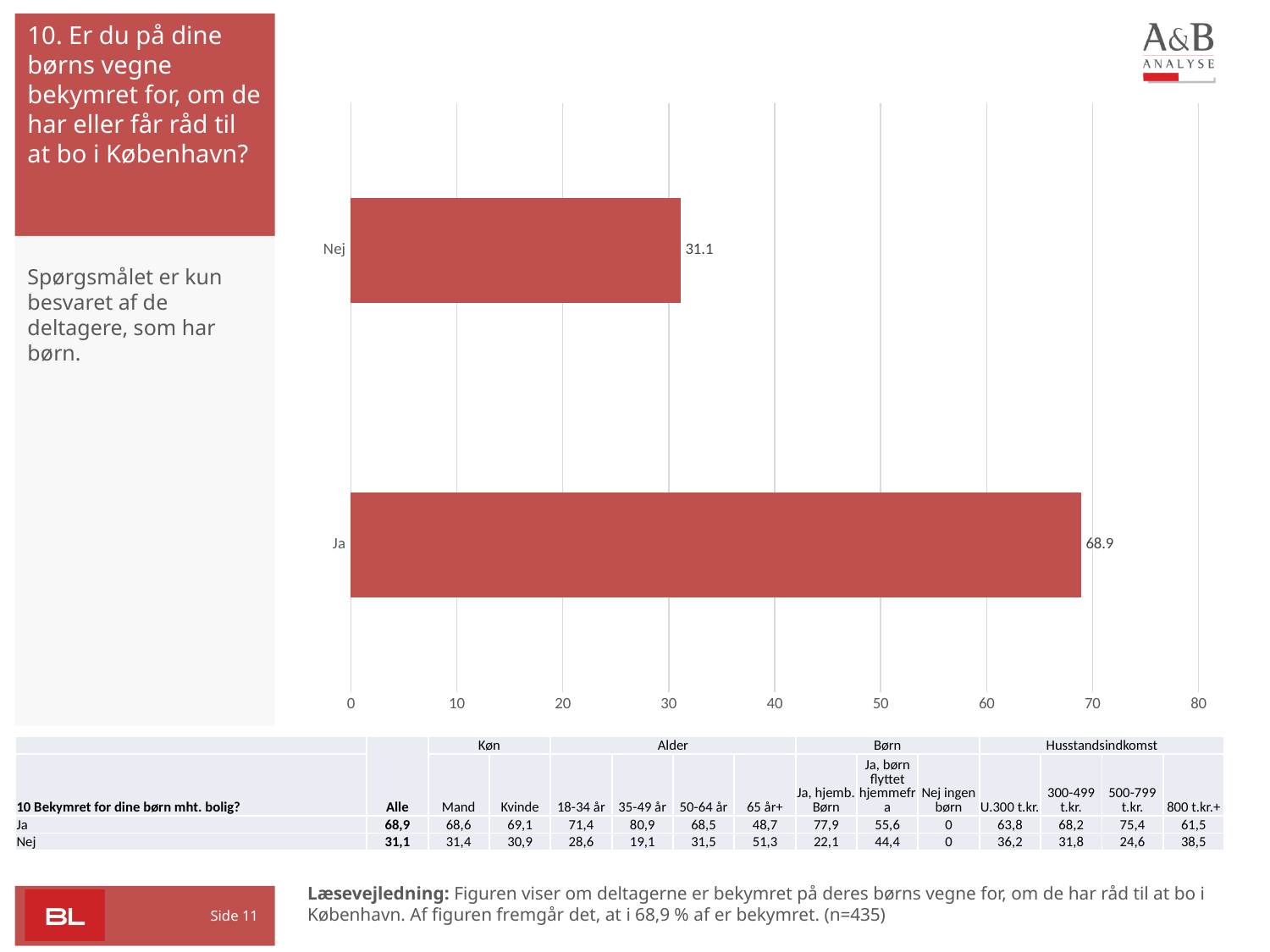
Is the value for "Nej" greater or less than 40? less How many categories are shown in the chart? 2 Which category has the highest value in the chart? Ja What colour are the bars in the chart? red Is the value for "Ja" greater or less than 60? greater What is the difference between the values for "Ja" and "Nej"? 37.8 What is the value for "Ja" in the chart? 68.9 Which category has the lowest value in the chart? Nej What kind of chart is shown on the slide? bar chart What is the value for "Nej" in the chart? 31.1 Which is larger, the value for "Ja" or the value for "Nej"? Ja What is the maximum value shown on the chart's horizontal axis? 80